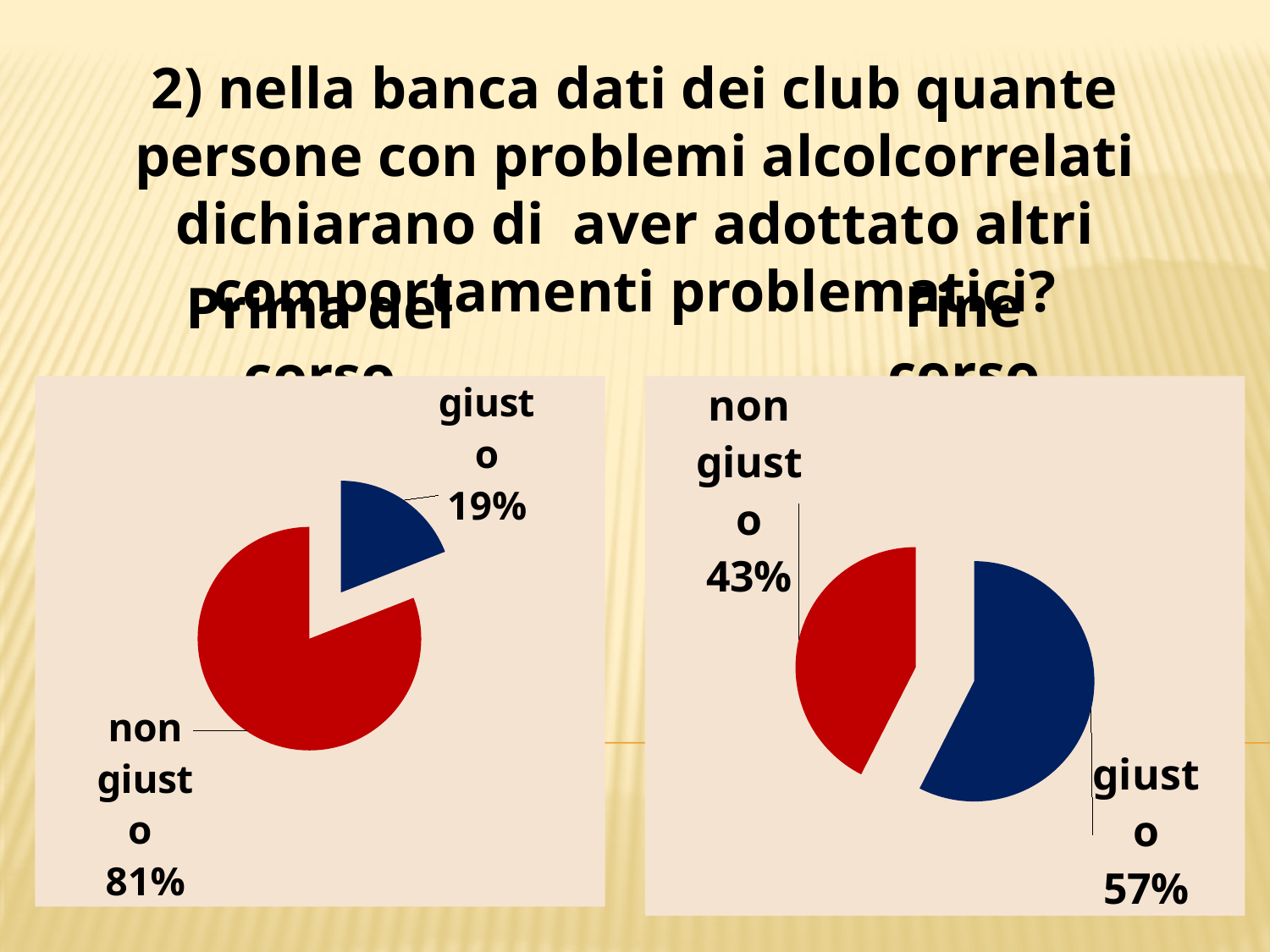
How many slices does the right pie chart have? 2 What type of chart is used on the left of the slide? pie chart In the right pie chart, what share is labelled "non giusto"? 43% In the left pie chart, which slice is the largest? non giusto In the left pie chart, what share is labelled "giusto"? 19% Is the "giusto" share larger in the left pie chart or in the right pie chart? right pie chart In the left pie chart, what share is labelled "non giusto"? 81% In the right pie chart, which slice is the smallest? non giusto In the right pie chart, which slice is the largest? giusto In the right pie chart, what is the difference between the "giusto" and "non giusto" shares? 14% In the right pie chart, what share is labelled "giusto"? 57% In the left pie chart, what is the difference between the "non giusto" and "giusto" shares? 62%